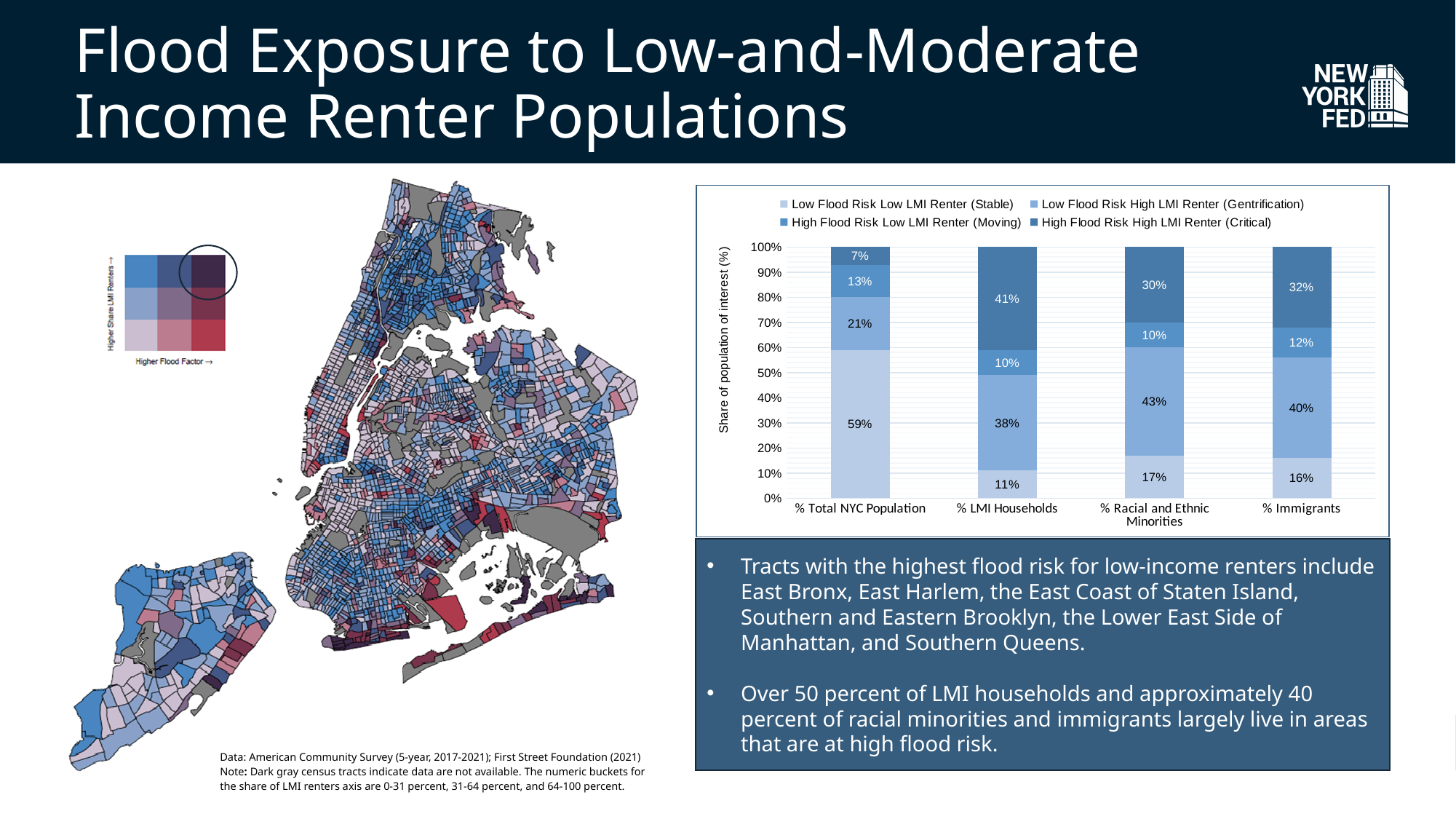
In the stacked bar chart, how many series does the legend list? 4 In the stacked bar chart, what is the difference between the Critical share for % Immigrants and the Critical share for % Total NYC Population? 25% In the stacked bar chart, which category has the lowest Low Flood Risk Low LMI Renter (Stable) share? % LMI Households In the stacked bar chart, what is the Low Flood Risk High LMI Renter (Gentrification) share for % Racial and Ethnic Minorities? 43% In the stacked bar chart, what is the Low Flood Risk Low LMI Renter (Stable) share for % Total NYC Population? 59% In the stacked bar chart, which category has the highest High Flood Risk High LMI Renter (Critical) share? % LMI Households What type of chart is shown on the right side of the slide? stacked bar chart In the stacked bar chart, how many categories are shown on the x axis? 4 In the stacked bar chart, what is the High Flood Risk Low LMI Renter (Moving) share for % Immigrants? 12% What is the label of the y axis of the stacked bar chart? Share of population of interest (%) In the stacked bar chart, what is the High Flood Risk High LMI Renter (Critical) share for % LMI Households? 41% In the stacked bar chart, is the Gentrification share larger for % Racial and Ethnic Minorities or for % Total NYC Population? % Racial and Ethnic Minorities